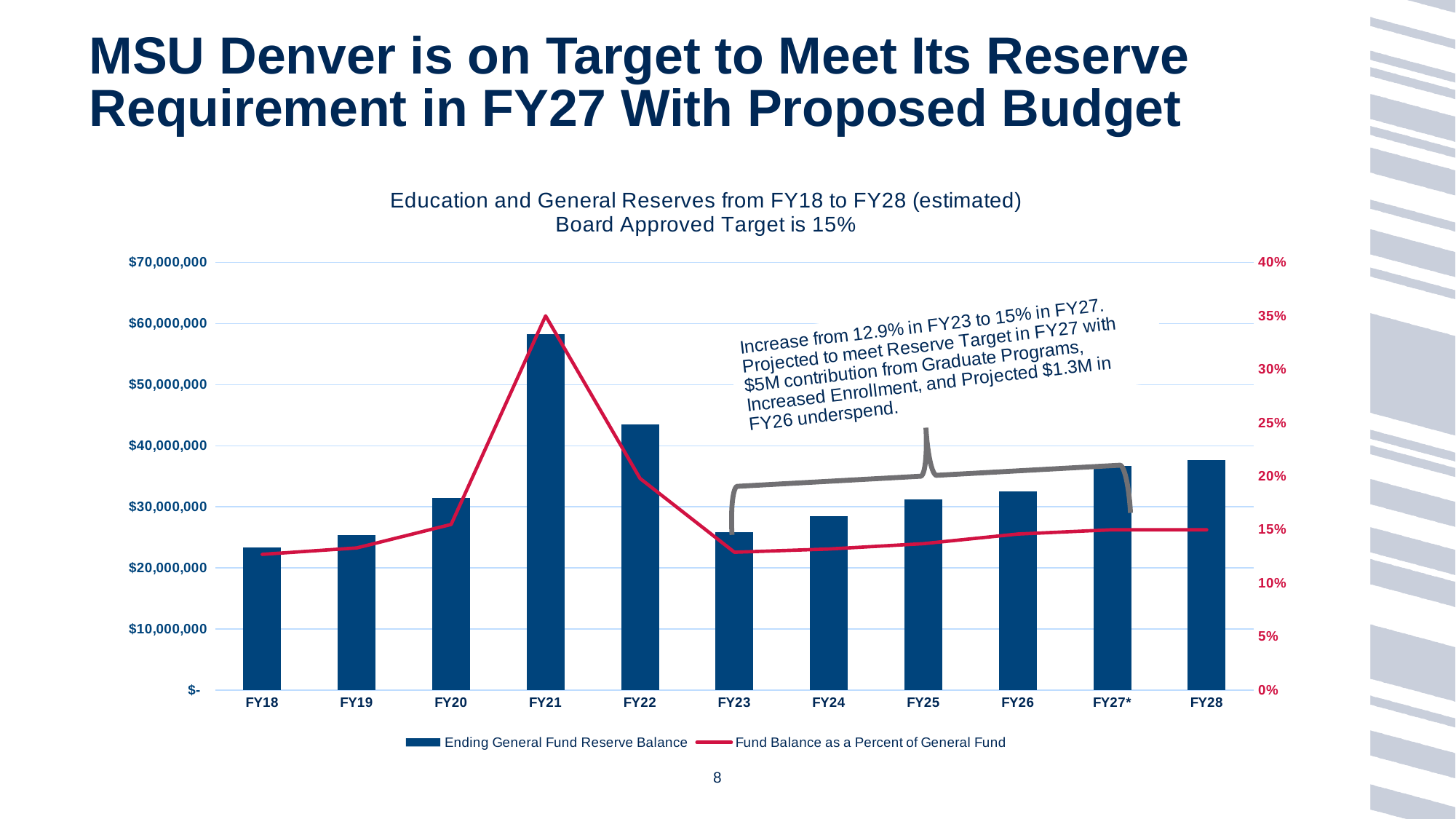
Is the Ending General Fund Reserve Balance for FY21 greater or less than $50,000,000? greater Which fiscal year has the highest Ending General Fund Reserve Balance? FY21 Do the Ending General Fund Reserve Balance bars rise or fall from FY23 to FY28? rise How many series does the chart legend list? 2 Is the Ending General Fund Reserve Balance for FY28 greater or less than $30,000,000? greater Which fiscal year has the lowest Ending General Fund Reserve Balance? FY18 What is the Board Approved Target percentage stated in the chart title? 15% Is the Fund Balance as a Percent of General Fund for FY21 greater or less than 30%? greater What type of chart is shown on the slide? Combined bar and line chart How many fiscal years are shown on the x axis of the chart? 11 Which has the larger Ending General Fund Reserve Balance, FY22 or FY28? FY22